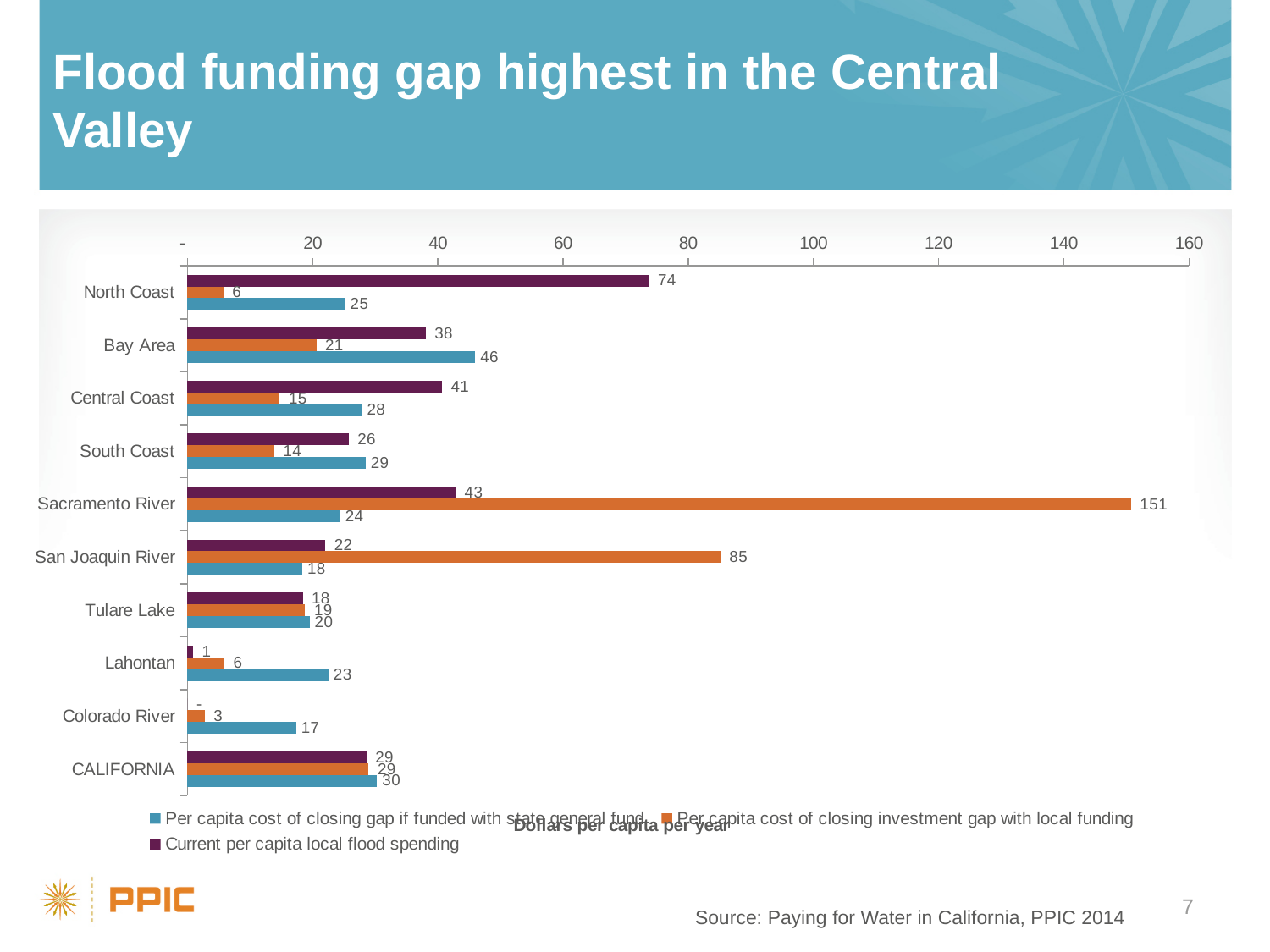
What is the per capita cost of closing the gap if funded with the state general fund for the Bay Area? 46 Which is larger for the Central Coast: current per capita local flood spending or the per capita cost of closing the gap if funded with the state general fund? Current per capita local flood spending Which region has the lowest per capita cost of closing the gap if funded with the state general fund? Colorado River Which region has the highest per capita cost of closing the investment gap with local funding? Sacramento River What is the x-axis title of the chart? Dollars per capita per year How many regions (categories) are plotted on the chart? 10 What is the difference between the per capita cost of closing the investment gap with local funding for the Sacramento River and the San Joaquin River? 66 What is the current per capita local flood spending for the North Coast? 74 What is the per capita cost of closing the investment gap with local funding for Lahontan? 6 What kind of chart is shown on the slide? bar chart What is the per capita cost of closing the investment gap with local funding for the Sacramento River region? 151 How many series does the legend list? 3